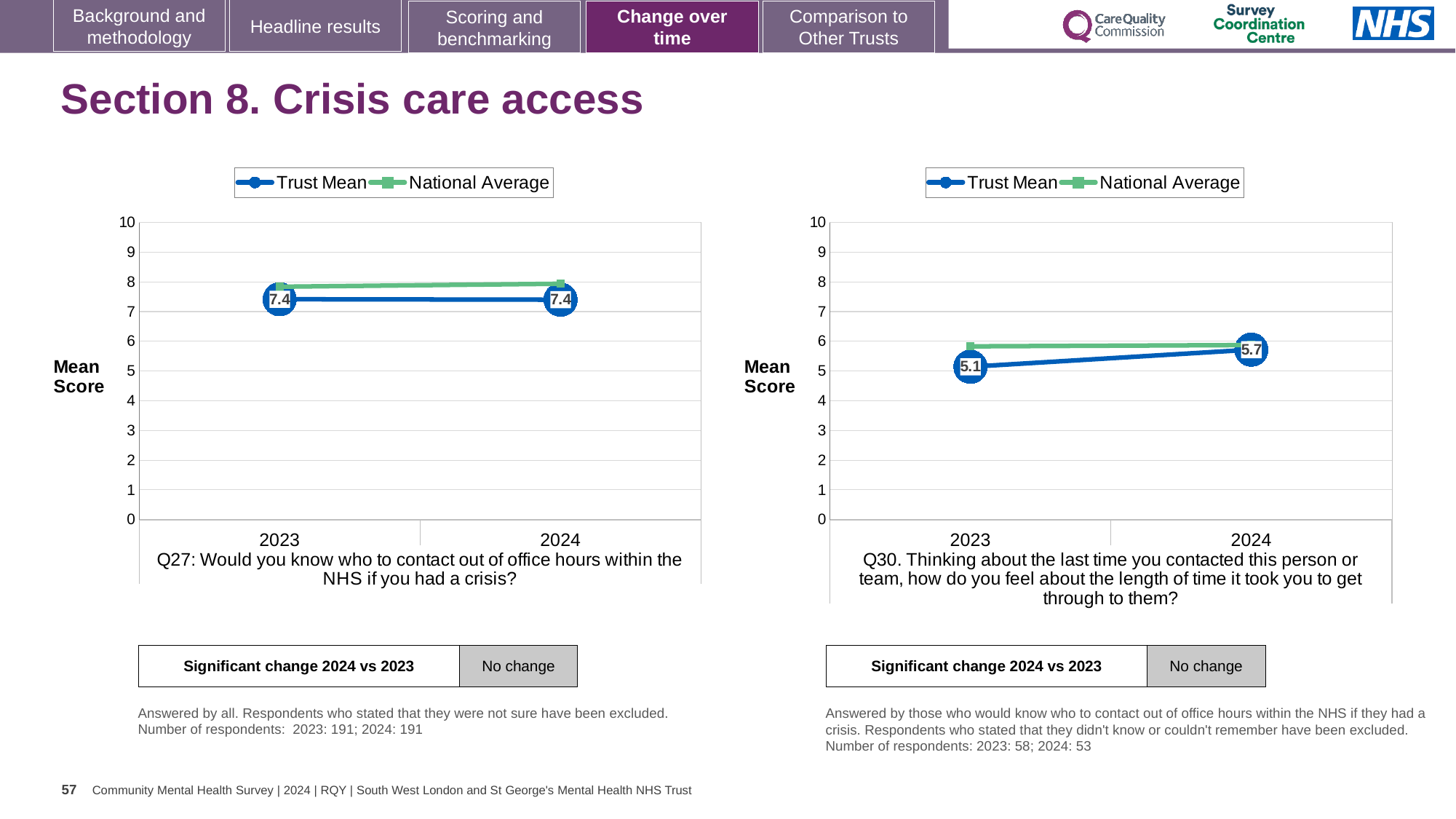
On the left chart (Q27), what is the Trust Mean score for 2024? 7.4 On the right chart (Q30), what is the Trust Mean score for 2024? 5.7 On the right chart (Q30), what is the Trust Mean score for 2023? 5.1 On the right chart (Q30), by how much did the Trust Mean change from 2023 to 2024? 0.6 On the left chart (Q27), what is the Trust Mean score for 2023? 7.4 How many years are plotted on the x axis of the left chart (Q27)? 2 How many series does the legend of the right chart (Q30) list? 2 On the right chart (Q30), does the Trust Mean rise or fall from 2023 to 2024? rise On the left chart (Q27), does the Trust Mean rise, fall or stay the same from 2023 to 2024? stay the same On the left chart (Q27), which series is higher in 2024, Trust Mean or National Average? National Average On the right chart (Q30), is the National Average value for 2023 greater or less than 5? greater What kind of chart is used on the left (Q27)? line chart